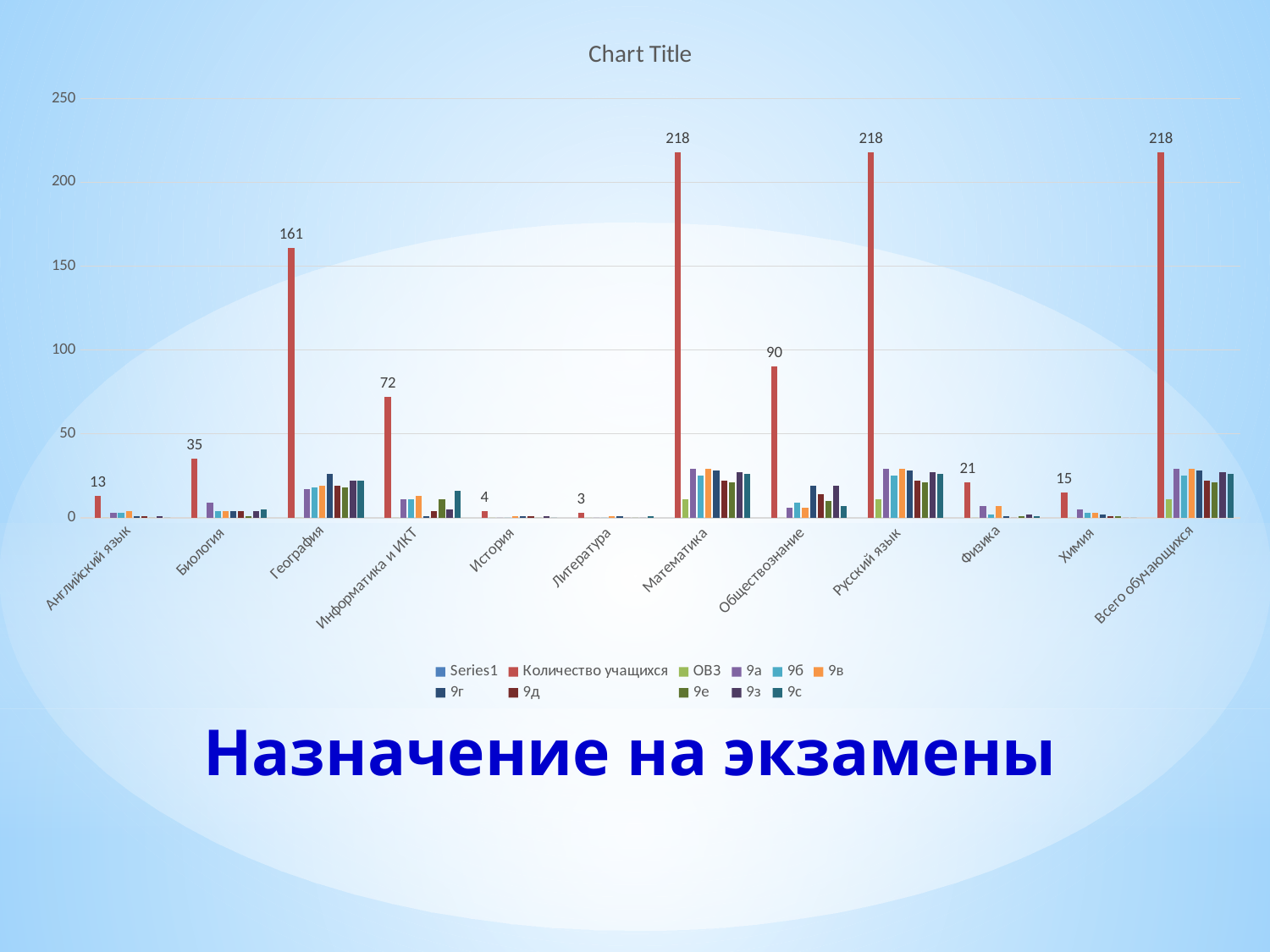
Which category has the lowest value for Количество учащихся? Литература Is the value of Количество учащихся for Математика greater or less than 200? greater What is the value of Количество учащихся for География? 161 How many categories are shown on the x axis? 12 What is the value of Количество учащихся for Информатика и ИКТ? 72 What kind of chart is shown on the slide? bar chart How many series does the legend list? 11 What is the value of Количество учащихся for Химия? 15 What is the highest value shown for Количество учащихся? 218 What is the difference between the Количество учащихся values for География and Информатика и ИКТ? 89 Which has a larger Количество учащихся value, Биология or Физика? Биология What is the value of Количество учащихся for Обществознание? 90